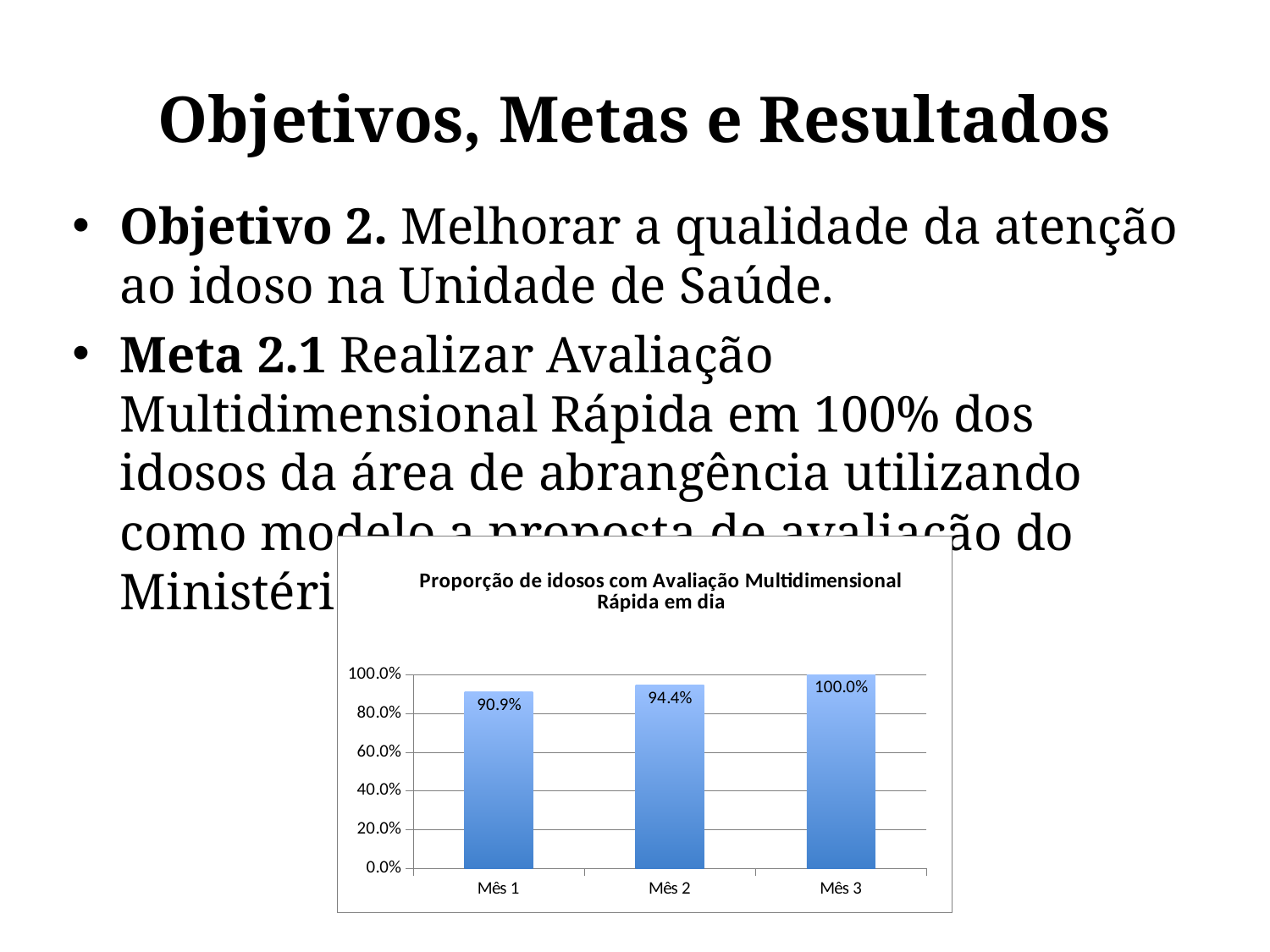
Which month has the lowest value? Mês 1 What is the title of the chart? Proporção de idosos com Avaliação Multidimensional Rápida em dia What is the value for Mês 3? 100.0% What is the difference between the values for Mês 2 and Mês 1? 3.5% What is the value for Mês 1? 90.9% How many months are shown on the x axis? 3 What is the value for Mês 2? 94.4% Which month has the highest value? Mês 3 What kind of chart is shown? Bar chart What is the difference between the values for Mês 3 and Mês 1? 9.1% Do the values rise or fall from Mês 1 to Mês 3? Rise Which is larger, the value for Mês 1 or Mês 2? Mês 2